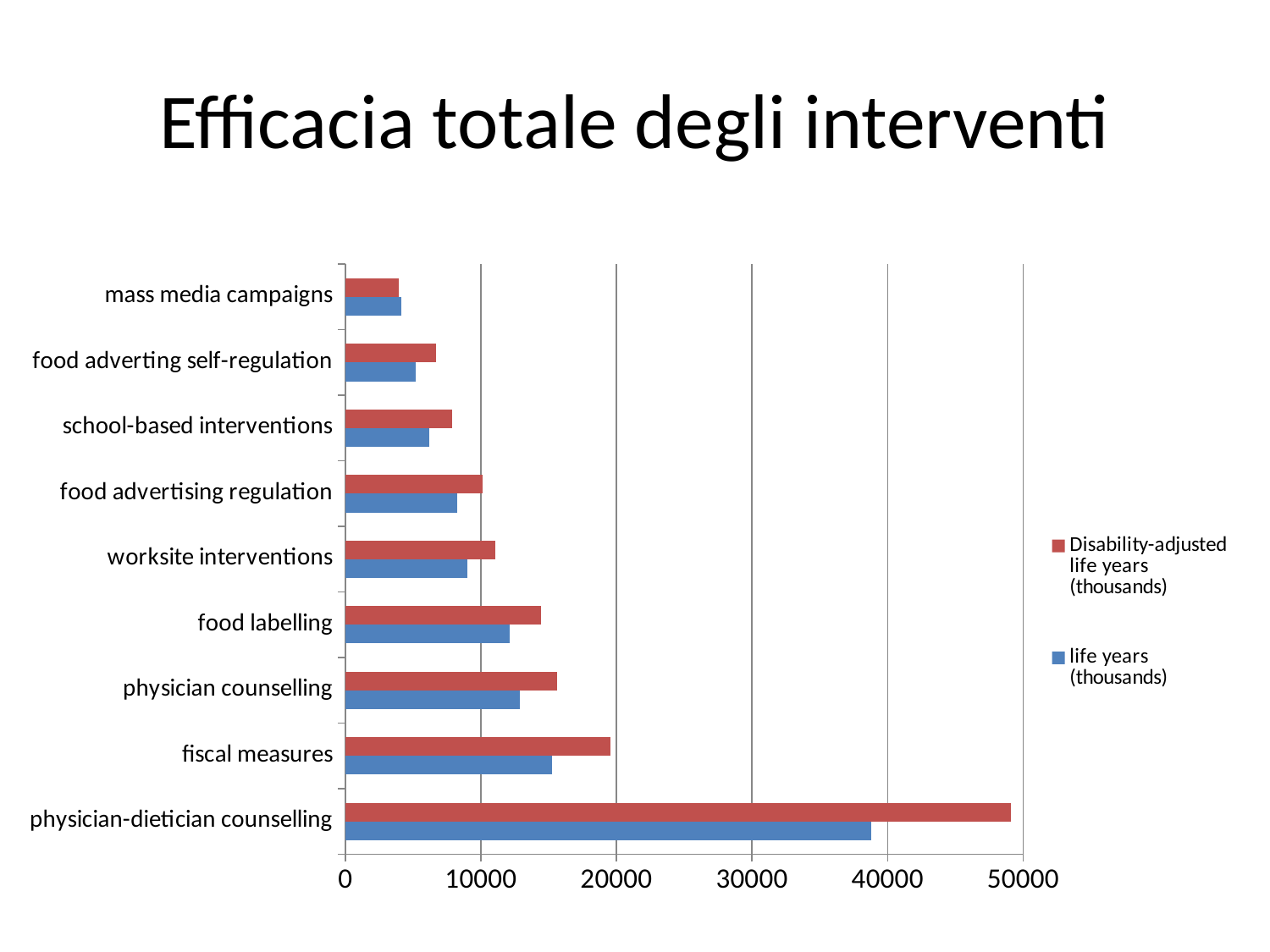
Is the Disability-adjusted life years (thousands) value for physician-dietician counselling greater or less than 40000? greater For school-based interventions, which series has the larger value, Disability-adjusted life years (thousands) or life years (thousands)? Disability-adjusted life years (thousands) What is the title of the chart on the slide? Efficacia totale degli interventi Which intervention has the highest value for Disability-adjusted life years (thousands)? physician-dietician counselling Is the Disability-adjusted life years (thousands) value for food labelling greater or less than 10000? greater Which intervention has the highest value for life years (thousands)? physician-dietician counselling Is the life years (thousands) value for physician-dietician counselling greater or less than 40000? less What kind of chart is shown on the slide? bar chart Which intervention has the lowest value for Disability-adjusted life years (thousands)? mass media campaigns How many intervention categories are plotted on the chart? 9 How many series does the legend list? 2 Which has the larger Disability-adjusted life years (thousands) value, fiscal measures or physician counselling? fiscal measures